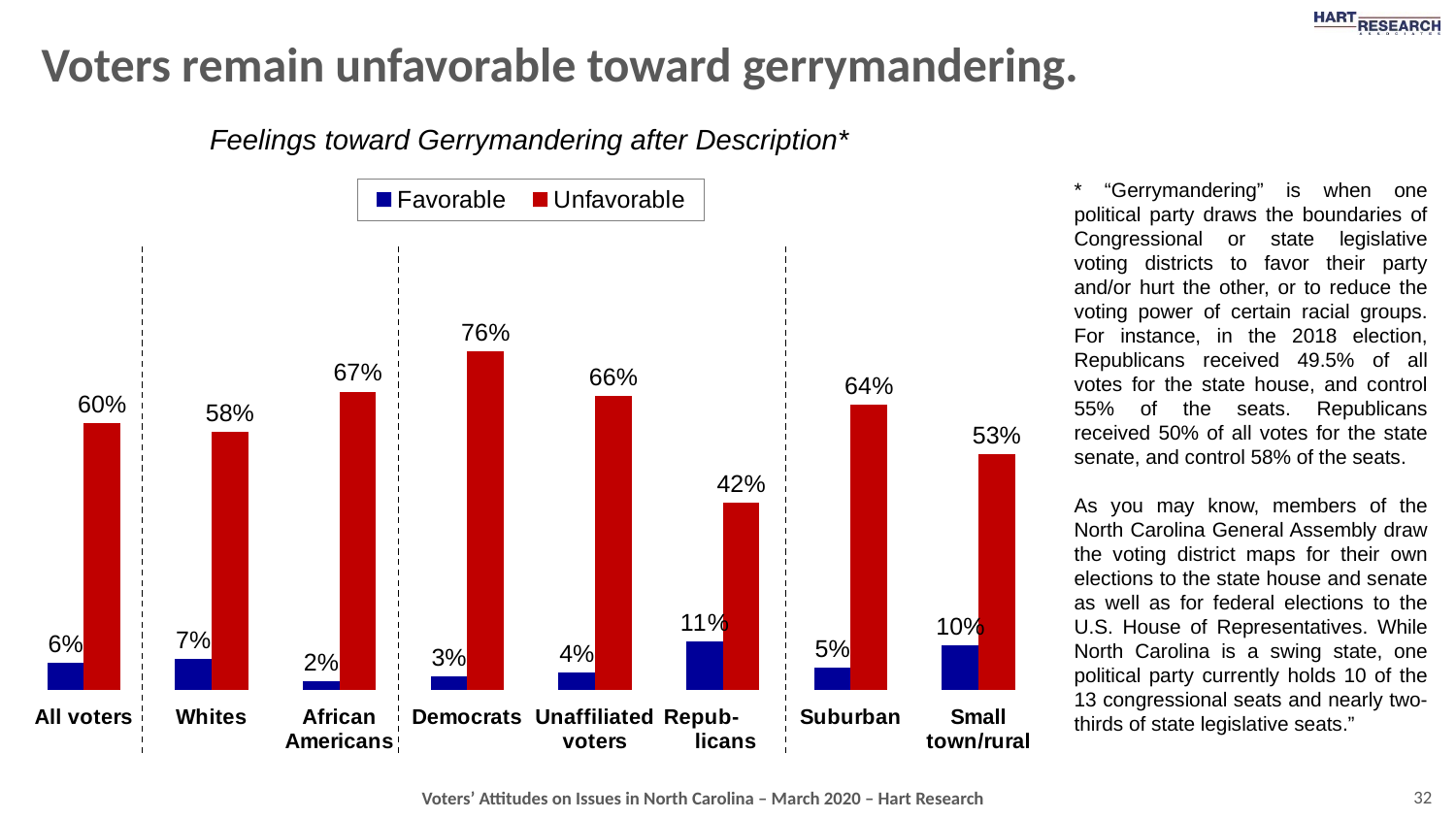
What is the Favorable value for Republicans? 11% What is the chart's title? Feelings toward Gerrymandering after Description* What is the Unfavorable value for All voters? 60% What kind of chart is shown on the slide? Bar chart Which category has the lowest Favorable value? African Americans Which category has the highest Unfavorable value? Democrats Which is larger, the Unfavorable value for Suburban or for Whites? Suburban What colour represents the Unfavorable series? Red What is the difference between the Unfavorable values for Democrats and Republicans? 34% What is the Unfavorable value for Small town/rural voters? 53% How many series does the legend list? 2 How many categories are shown on the x axis? 8